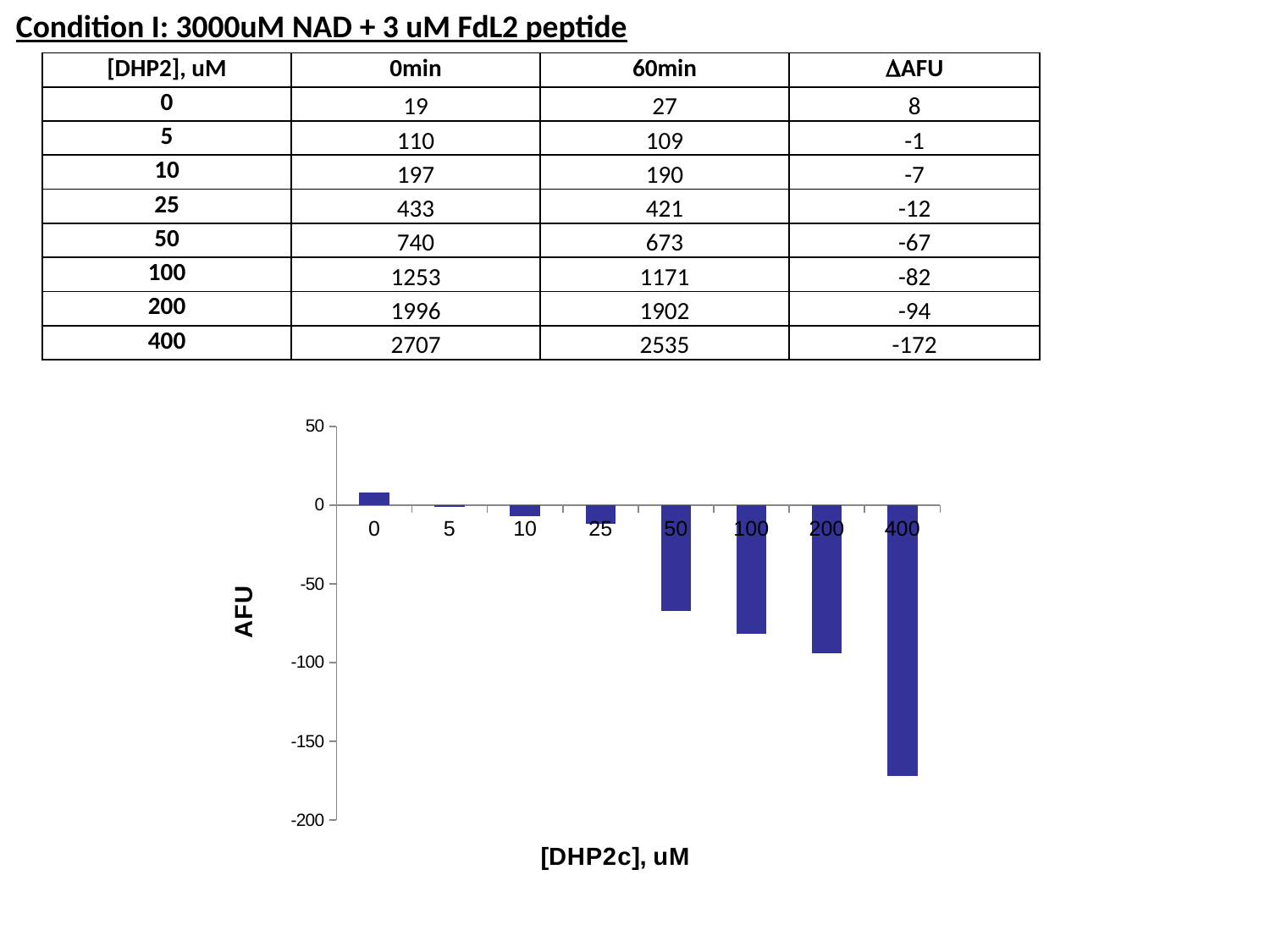
Do the AFU values generally rise or fall as the DHP2c concentration increases along the x axis? fall Which DHP2c concentration has the highest AFU value in the chart? 0 Is the AFU value for 400 uM DHP2c greater or less than -150? less What is the label of the x axis of the chart? [DHP2c], uM Which has a larger AFU value in the chart, 100 uM or 400 uM DHP2c? 100 uM Is the AFU value for 200 uM DHP2c greater or less than -50? less What kind of chart is shown on the slide? bar chart What is the ΔAFU value plotted for 400 uM DHP2c, as given in the table on the slide? -172 What is the label of the y axis of the chart? AFU Which DHP2c concentration has the lowest (most negative) AFU value in the chart? 400 How many bars (DHP2c concentrations) are plotted in the chart? 8 Is the AFU value for 50 uM DHP2c greater or less than -100? greater